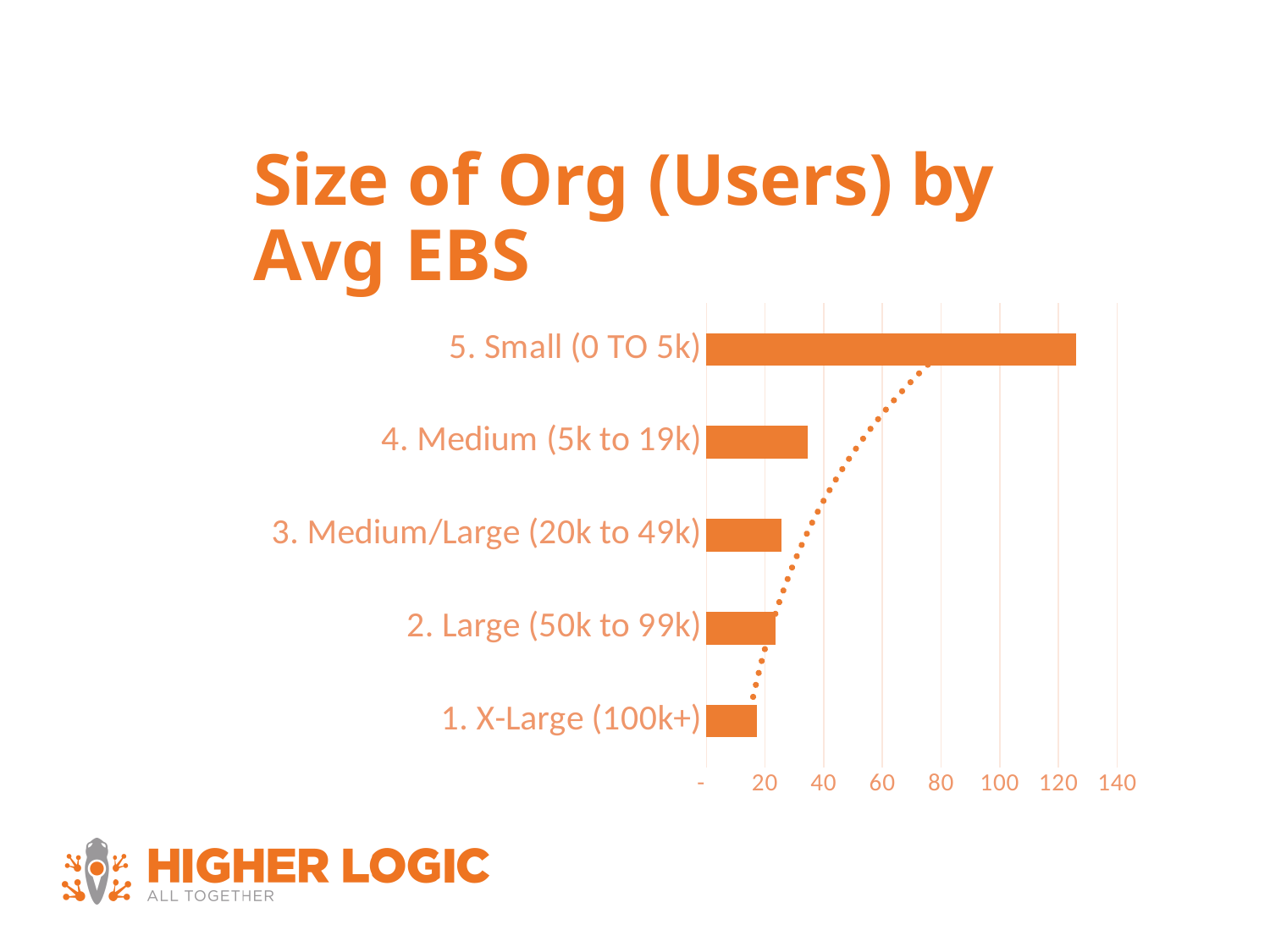
How many categories are plotted in the chart? 5 Which is larger, the value for 4. Medium (5k to 19k) or the value for 1. X-Large (100k+)? 4. Medium (5k to 19k) Which category has the highest value? 5. Small (0 TO 5k) Is the value for 1. X-Large (100k+) greater or less than 20? less What is the title of the chart? Size of Org (Users) by Avg EBS Do the bars get longer or shorter going from the top category to the bottom category? shorter What kind of chart is shown on the slide? bar chart Is the value for 4. Medium (5k to 19k) greater or less than 40? less Is the value for 3. Medium/Large (20k to 49k) greater or less than 40? less Which is larger, the value for 5. Small (0 TO 5k) or the value for 4. Medium (5k to 19k)? 5. Small (0 TO 5k)